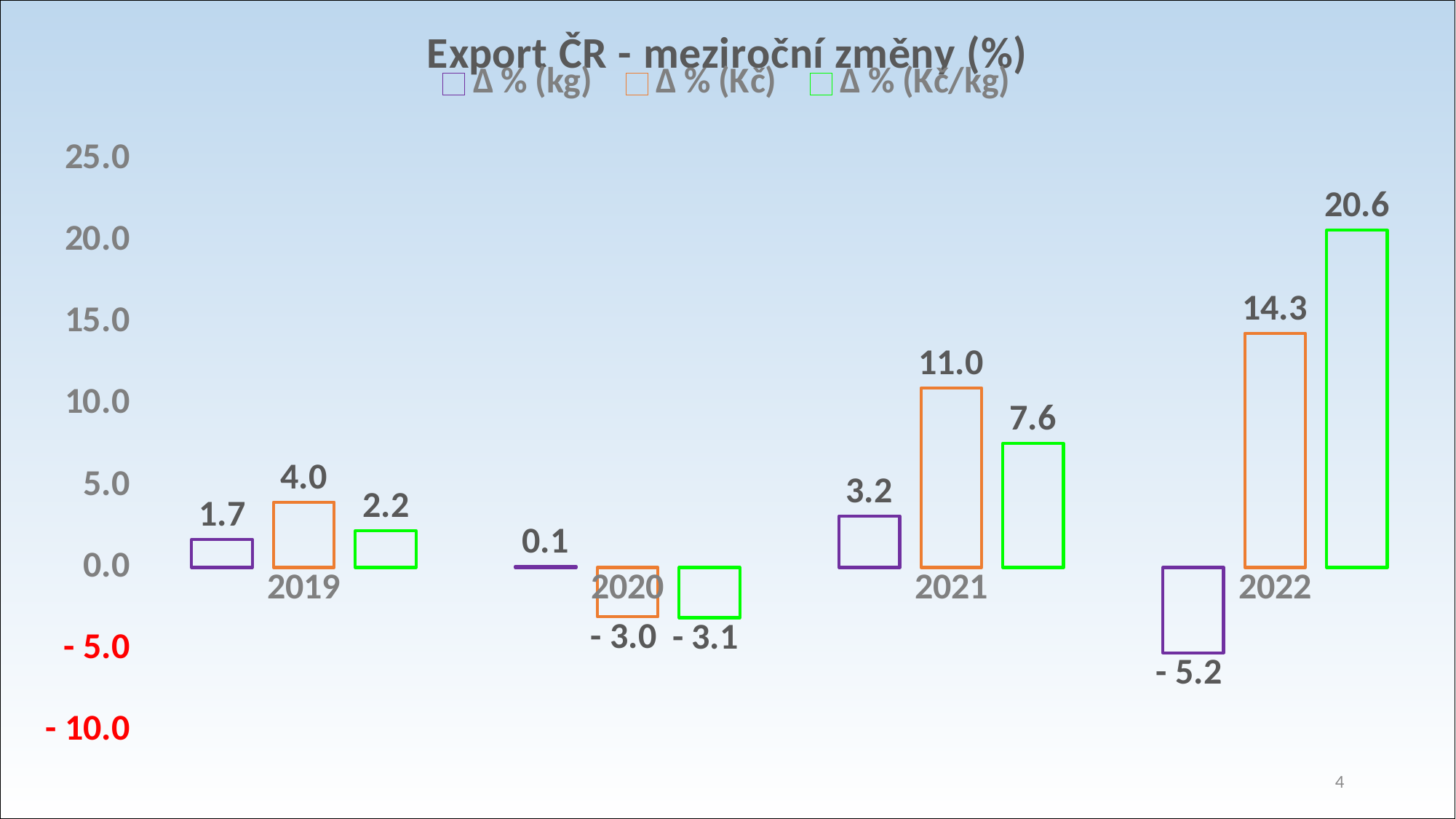
What is the value of Δ % (kg) for 2022? - 5.2 What kind of chart is shown on the slide? bar chart Which year has the highest value for Δ % (Kč/kg)? 2022 What is the difference between Δ % (Kč) and Δ % (kg) in 2021? 7.8 Which is larger in 2019: Δ % (Kč) or Δ % (Kč/kg)? Δ % (Kč) How many years are shown on the x axis? 4 What is the value of Δ % (Kč) for 2021? 11.0 What is the value of Δ % (Kč/kg) for 2020? - 3.1 What is the title of the chart? Export ČR - meziroční změny (%) Which year has the lowest value for Δ % (kg)? 2022 How many series does the legend list? 3 What is the value of Δ % (kg) for 2019? 1.7